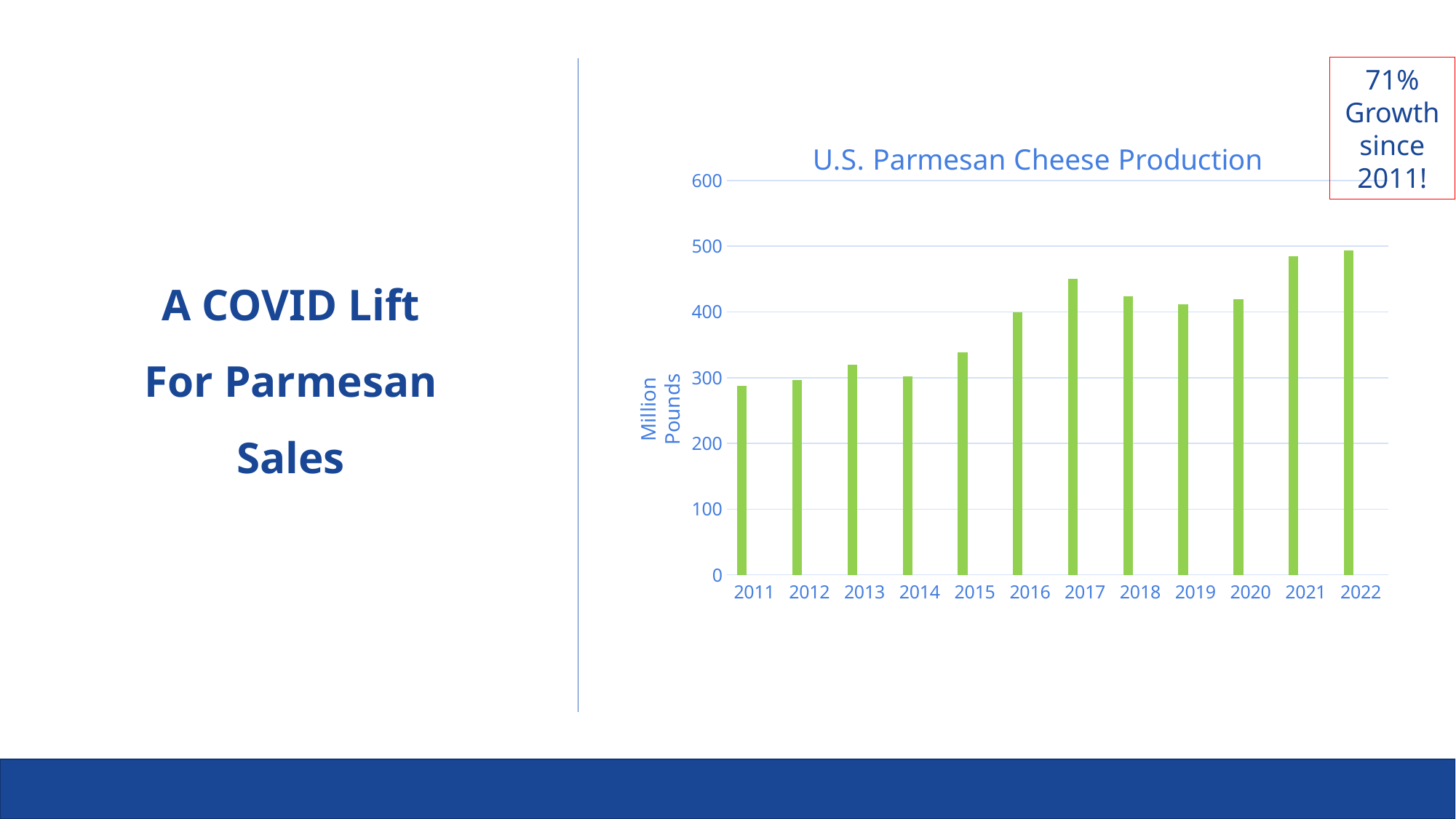
Is the value for 2017 greater or less than 400? greater How many years are shown on the x axis of the chart? 12 Overall, do the values rise or fall from 2011 to 2022? Rise Is the value for 2021 greater or less than 500? less Which year has the larger value, 2017 or 2018? 2017 What is the label on the vertical axis of the chart? Million Pounds What is the title of the chart? U.S. Parmesan Cheese Production What kind of chart is shown on the slide? Bar chart Which year has the larger value, 2014 or 2015? 2015 Is the value for 2011 greater or less than 300? less